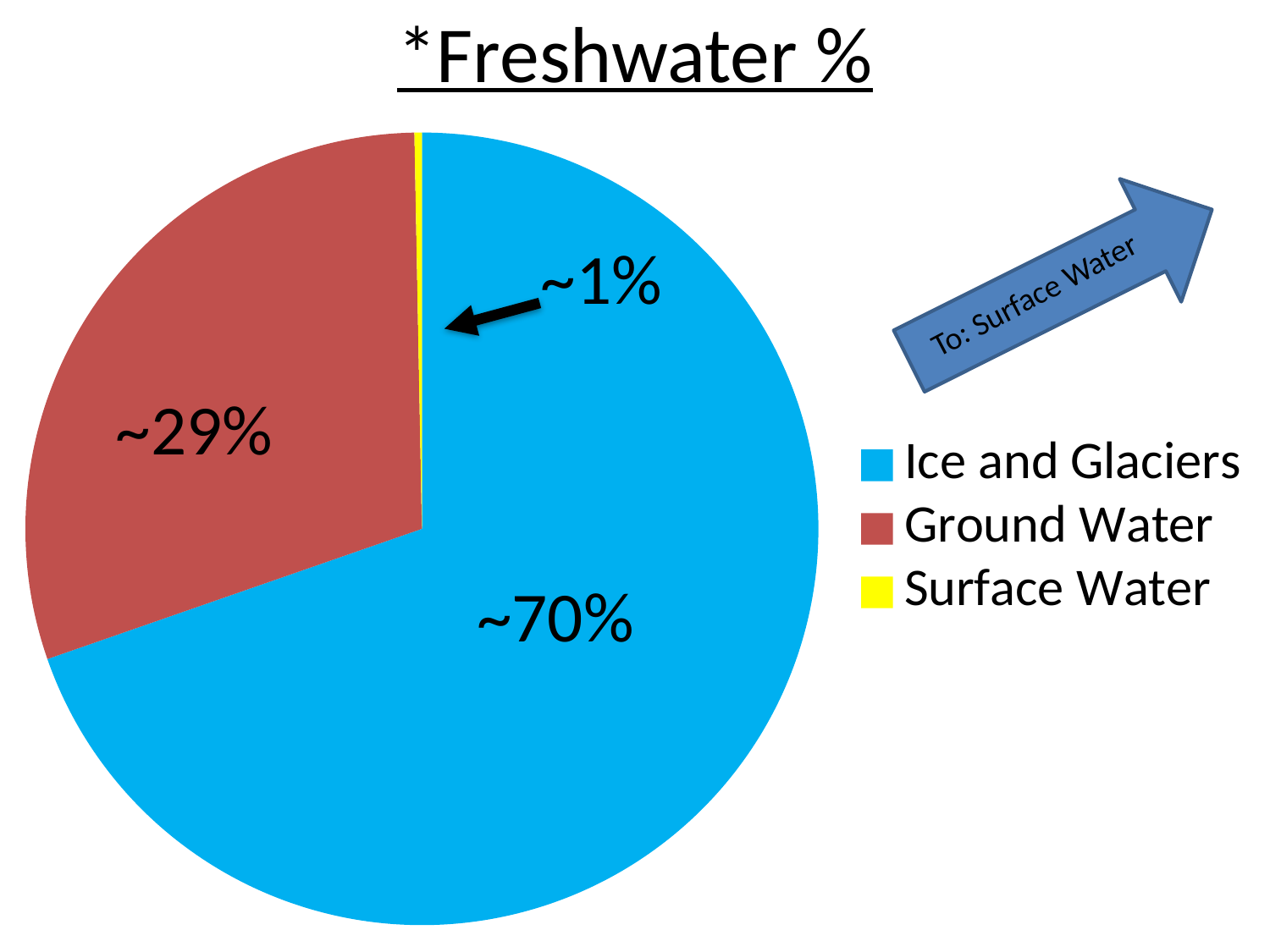
What label is printed on the Ice and Glaciers slice? ~70% Which category has the largest slice of the pie? Ice and Glaciers What label is printed for the Surface Water slice? ~1% What is the title of the chart? *Freshwater % Which is larger, the Surface Water slice or the Ground Water slice? Ground Water How many slices does the pie chart have? 3 Which category has the smallest slice of the pie? Surface Water What colour is the Surface Water slice in the legend? yellow Which is larger, the Ground Water slice or the Ice and Glaciers slice? Ice and Glaciers How many entries does the legend list? 3 What label is printed on the Ground Water slice? ~29% What kind of chart is shown on the slide? pie chart